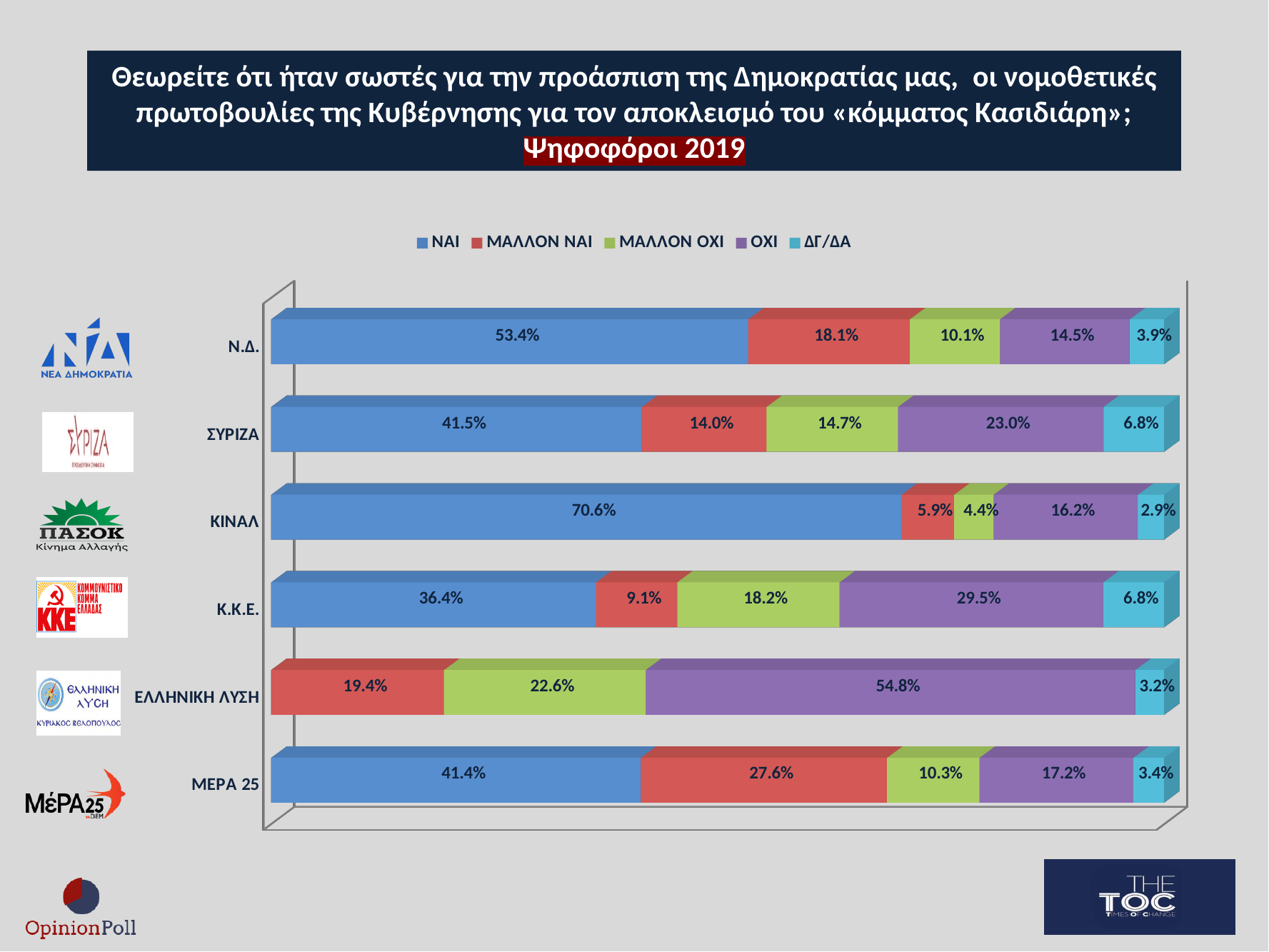
What is the ΜΑΛΛΟΝ ΝΑΙ value for ΜΕΡΑ 25? 27.6% How many series does the legend list? 5 Which party has the highest ΝΑΙ value? ΚΙΝΑΛ What is the total of the ΜΑΛΛΟΝ ΟΧΙ and ΟΧΙ values for Κ.Κ.Ε.? 47.7% What is the ΝΑΙ value for ΚΙΝΑΛ? 70.6% Which party has the lowest ΔΓ/ΔΑ value? ΚΙΝΑΛ Which is larger, the ΟΧΙ value for Κ.Κ.Ε. or the ΟΧΙ value for ΣΥΡΙΖΑ? Κ.Κ.Ε. How many party categories are shown on the chart? 6 What type of chart is shown on the slide? stacked bar chart Which party's bar has no ΝΑΙ segment? ΕΛΛΗΝΙΚΗ ΛΥΣΗ What is the ΟΧΙ value for ΕΛΛΗΝΙΚΗ ΛΥΣΗ? 54.8% What is the difference between the ΝΑΙ values for Ν.Δ. and ΣΥΡΙΖΑ? 11.9%